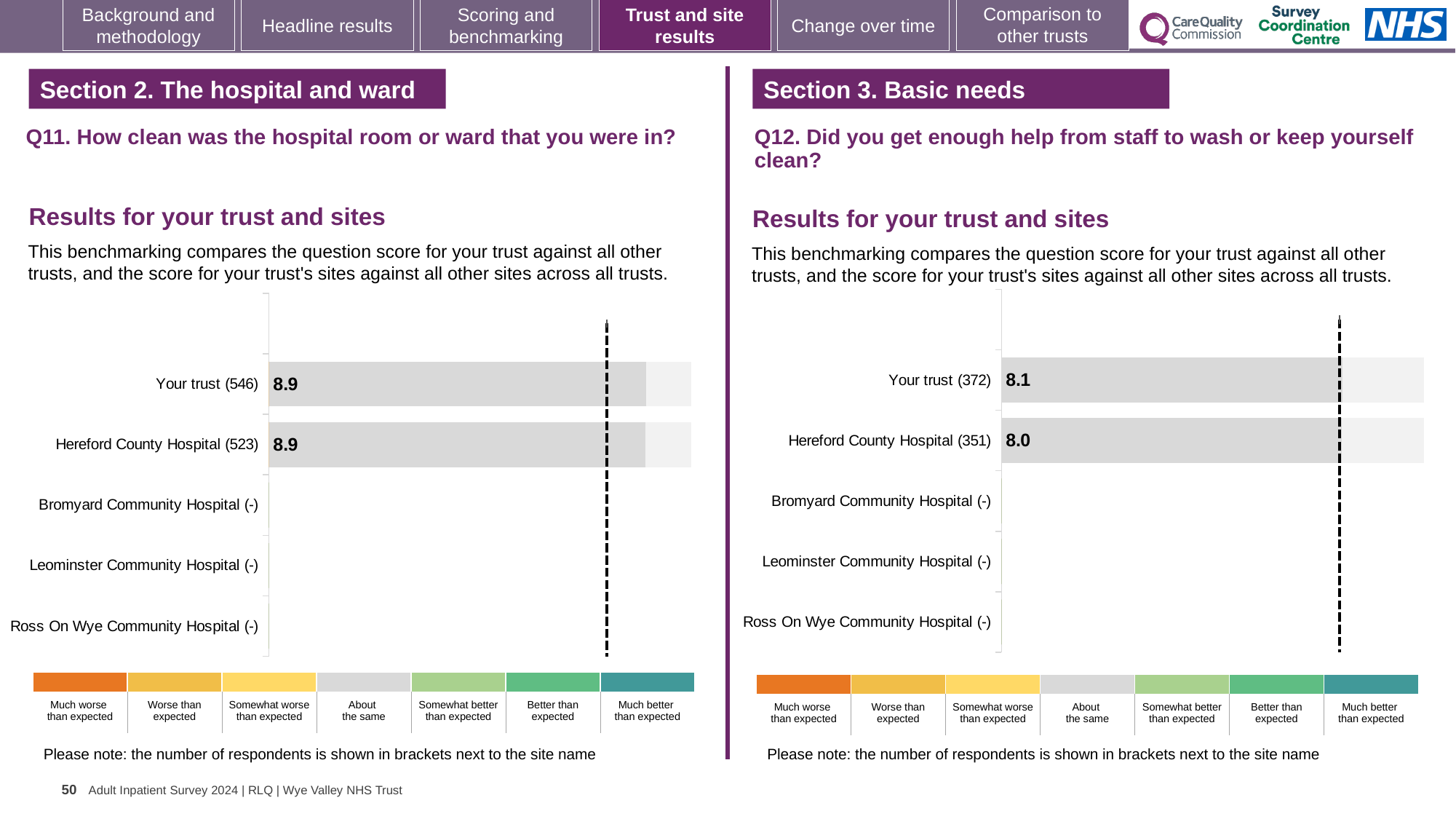
What kind of chart is used for the Q12 results (right)? Bar chart On the Q11 chart (left), how many sites show no score (marked with a dash)? 3 How many site/trust categories are listed on the Q11 chart (left)? 5 On the Q12 chart (right), which has the higher score, Your trust or Hereford County Hospital? Your trust On the Q11 chart (left), what is the difference between the score for Your trust and the score for Hereford County Hospital? 0 On the Q11 chart (left), what is the score for Hereford County Hospital (523)? 8.9 On the Q12 chart (right), how many respondents are shown for Hereford County Hospital? 351 On the Q11 chart (left), what is the score for Your trust (546)? 8.9 On the Q12 chart (right), what is the score for Hereford County Hospital (351)? 8.0 On the Q11 chart (left), how many respondents are shown for Your trust? 546 On the Q12 chart (right), what is the difference between the score for Your trust and the score for Hereford County Hospital? 0.1 On the Q12 chart (right), what is the score for Your trust (372)? 8.1